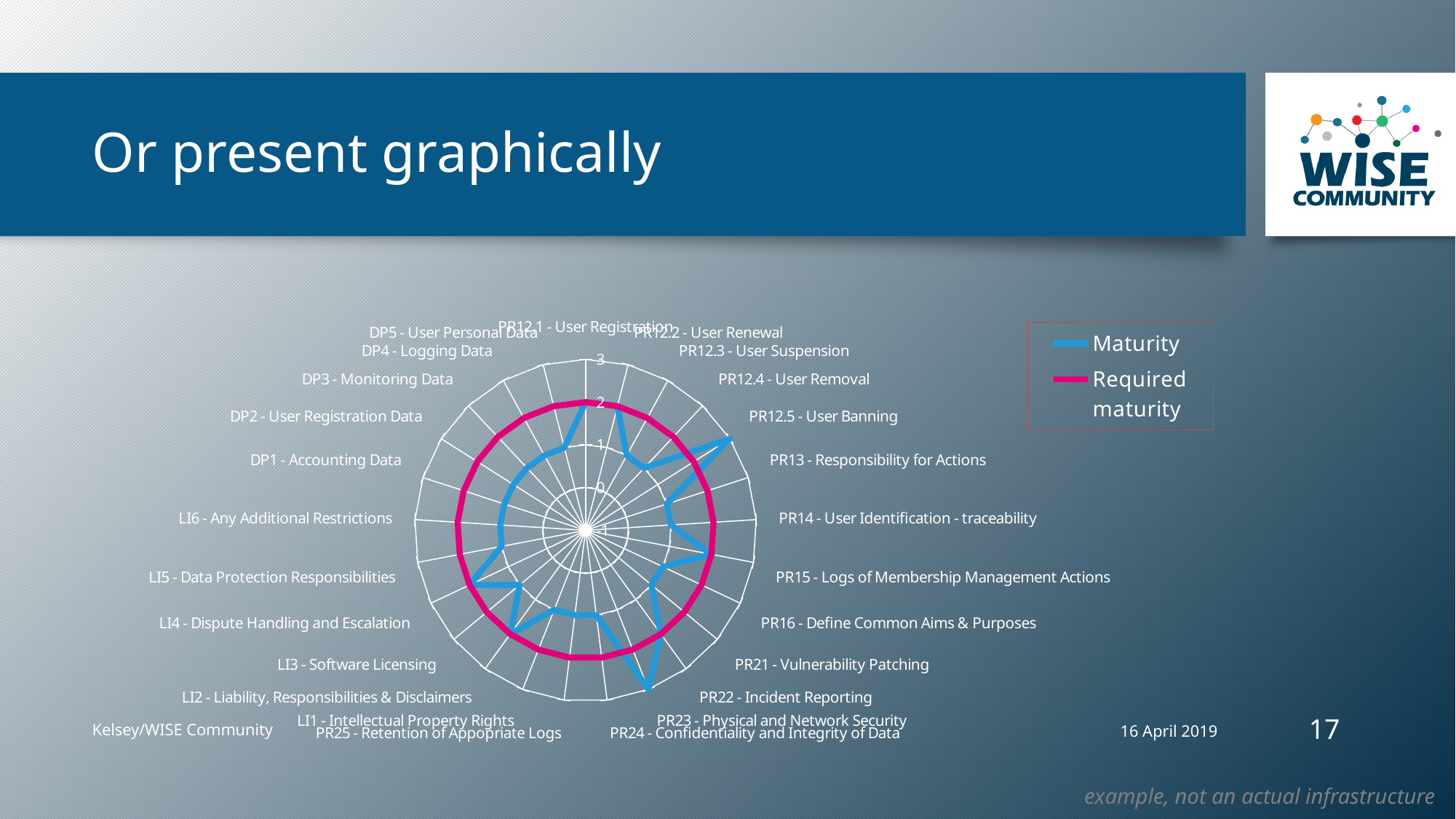
Which colour represents the Maturity series in the legend? Blue How many series does the legend list? 2 How many categories are plotted around the radar chart? 25 Is the Maturity value for PR12.5 - User Banning greater or less than 2? greater What is the Required maturity value for LI3 - Software Licensing? 2 What is the Required maturity value for PR12.1 - User Registration? 2 Is the Maturity value for DP1 - Accounting Data greater or less than 2? less What kind of chart is shown on the slide? Radar chart